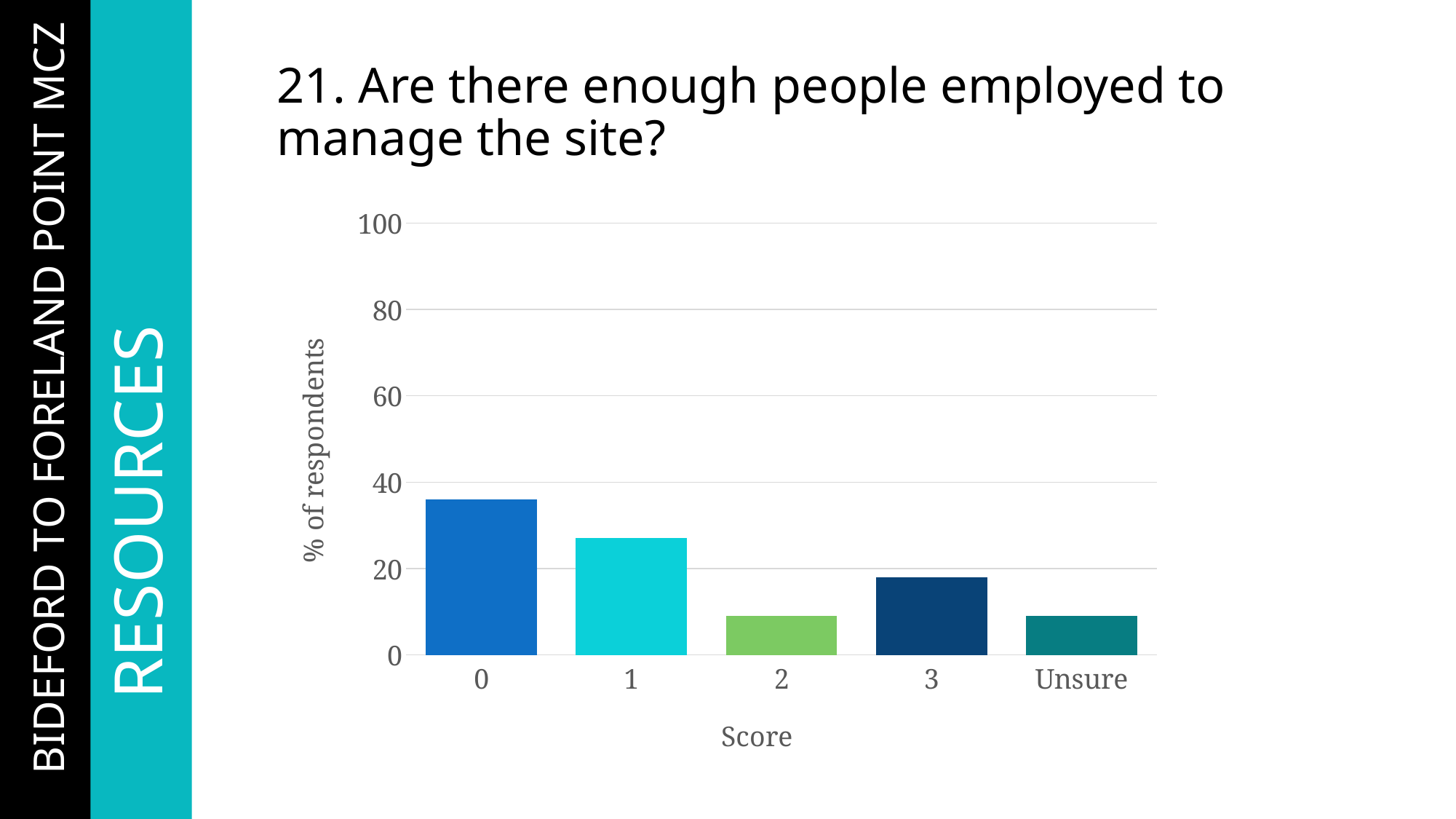
Is the value for score 0 greater or less than 20? greater Is the value for score 2 greater or less than 20? less What is the label on the y axis of the chart? % of respondents What kind of chart is shown on the slide? bar chart Which score category has the highest percentage of respondents? 0 Is the value for score 1 greater or less than 20? greater Which has a higher percentage of respondents, score 0 or score 1? 0 Which has a higher percentage of respondents, score 3 or score 2? 3 How many score categories are shown on the x axis? 5 What is the label on the x axis of the chart? Score